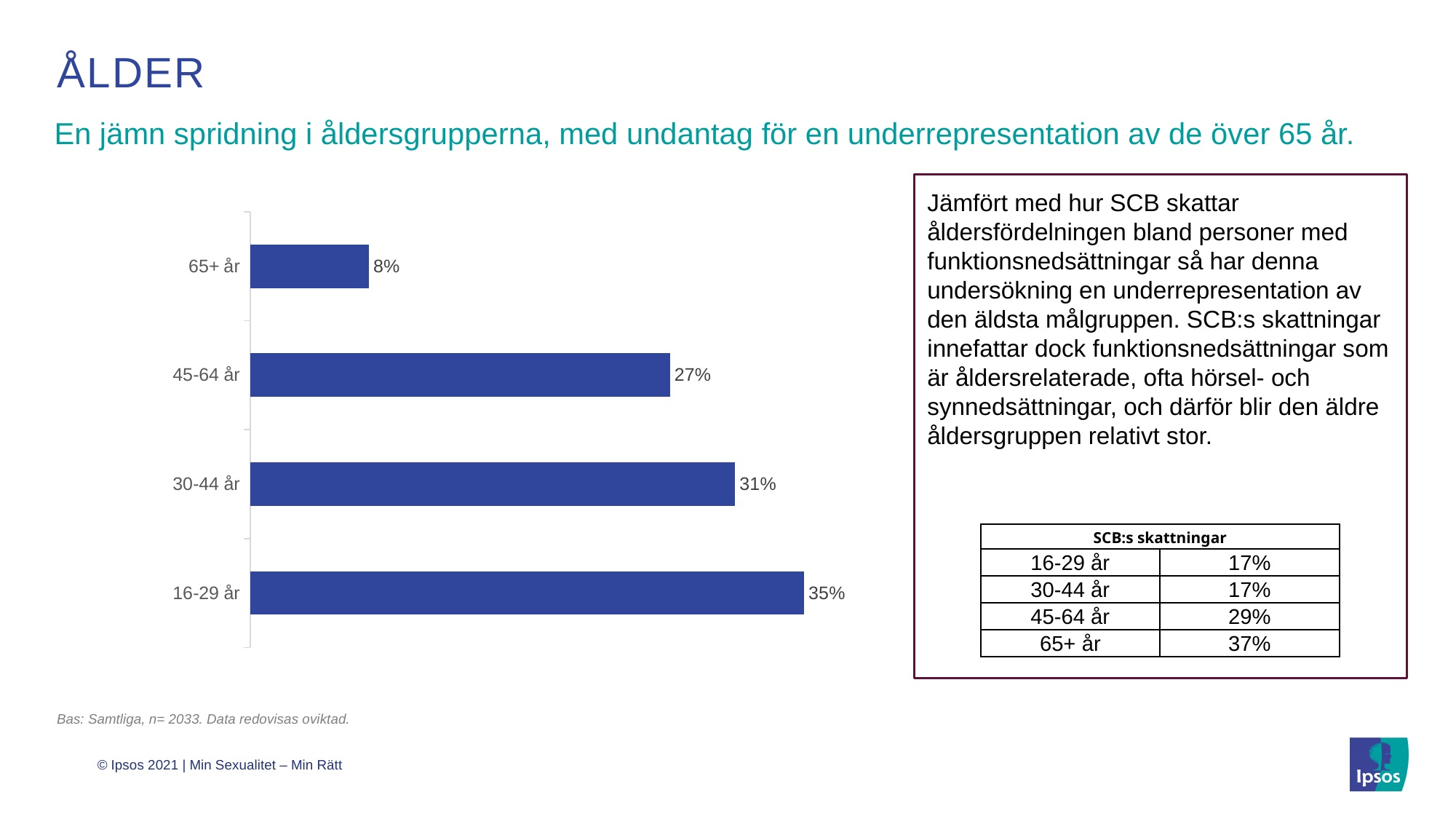
How many age groups are shown in the chart? 4 Which is larger, the value for 30-44 år or the value for 45-64 år? 30-44 år Which age group has the lowest value? 65+ år What is the value for the 65+ år age group? 8% What is the difference between the values for 30-44 år and 45-64 år? 4 percentage points What is the value for the 30-44 år age group? 31% What is the value for the 16-29 år age group? 35% What is the difference between the values for 16-29 år and 65+ år? 27 percentage points What is the value for the 45-64 år age group? 27% What is the title of the slide containing the chart? ÅLDER What kind of chart is shown on the slide? Bar chart Which age group has the highest value? 16-29 år